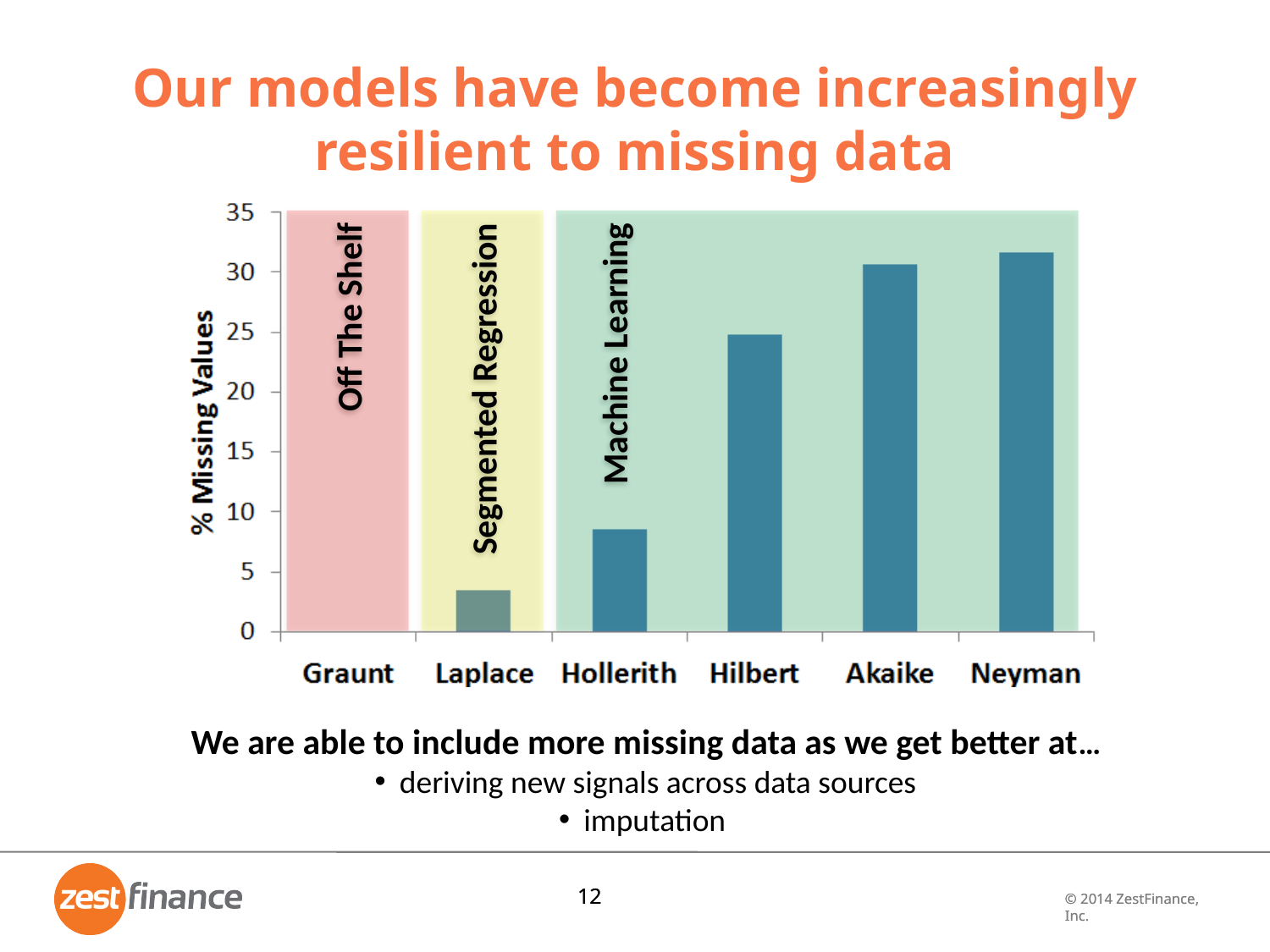
Is the value for Neyman greater or less than 30? greater What kind of chart is shown on the slide? bar chart Which group label is shown above the Graunt category in the chart? Off The Shelf Which has the larger value, Laplace or Hollerith? Hollerith What is the label on the y axis of the chart? % Missing Values Is the value for Akaike greater or less than 25? greater Is the value for Hollerith greater or less than 10? less How many categories are shown on the x axis of the chart? 6 Which has the larger value, Hilbert or Akaike? Akaike Do the values generally rise or fall from Graunt to Neyman along the x axis? rise